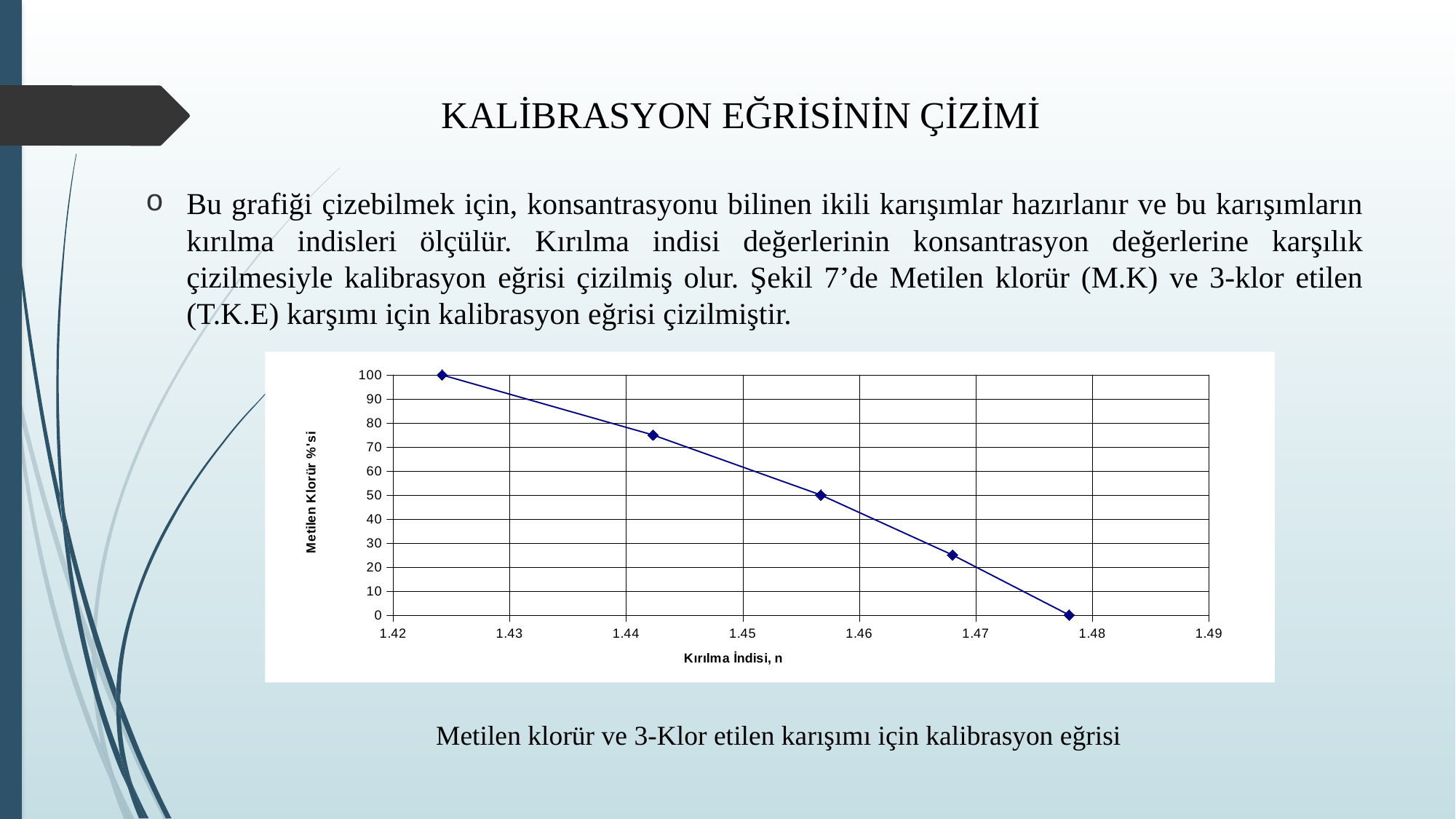
Is the Metilen Klorür % value of the second data point (near refractive index 1.44) greater or less than 70? greater Do the values rise or fall as the refractive index (Kırılma İndisi) increases along the x axis? fall What is the label of the x axis of the chart? Kırılma İndisi, n What is the highest Metilen Klorür % value plotted on the chart? 100 Is the refractive index of the point with 100% Metilen Klorür greater or less than 1.43? less Is the refractive index of the point with 0% Metilen Klorür greater or less than 1.47? greater How many data points are plotted on the chart? 5 Which has the higher Metilen Klorür %: the point near refractive index 1.44 or the point near refractive index 1.47? the point near 1.44 What kind of chart is shown on the slide? line chart What is the lowest Metilen Klorür % value plotted on the chart? 0 What is the label of the y axis of the chart? Metilen Klorür %'si